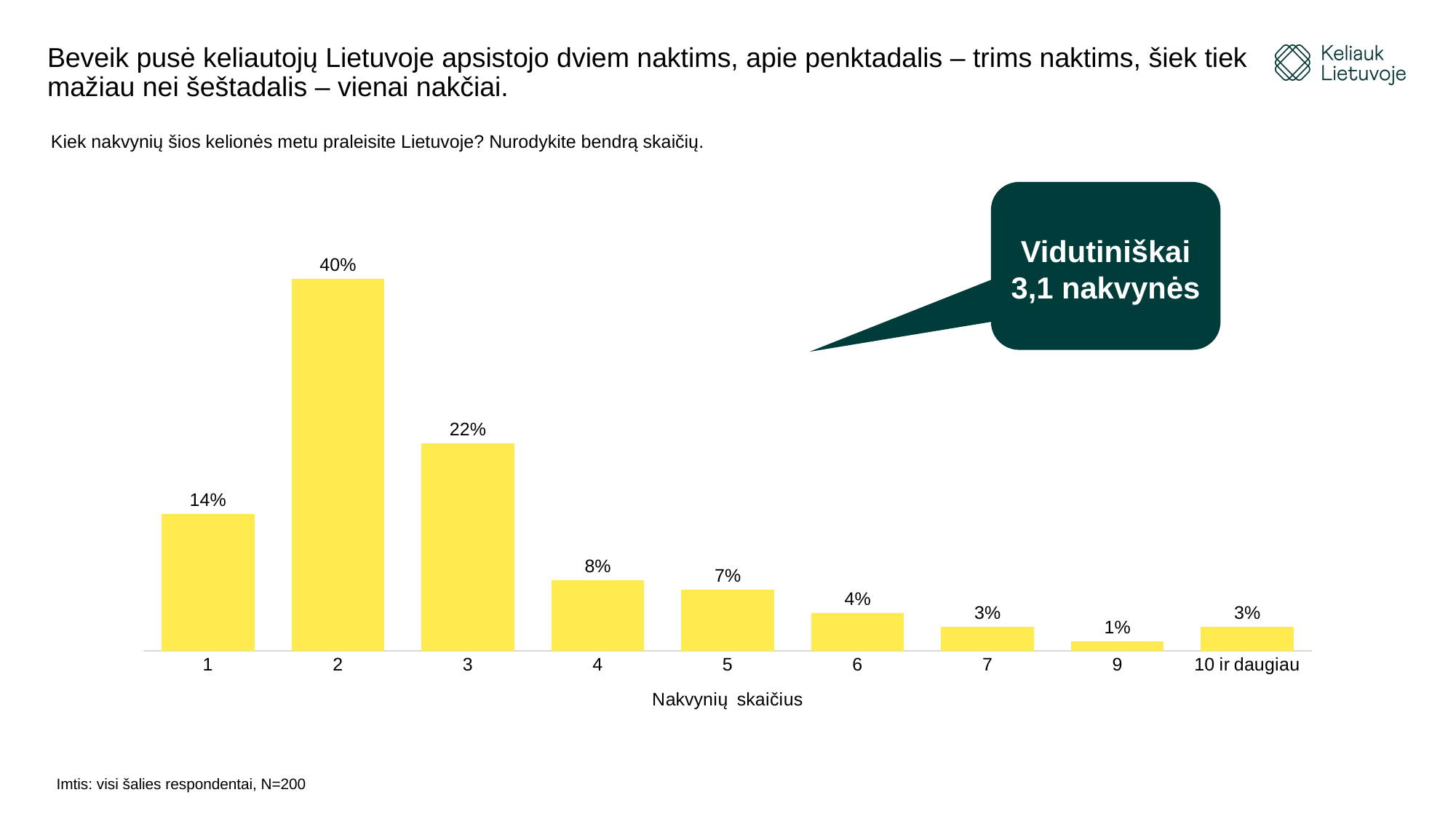
What is the x-axis title of the chart? Nakvynių skaičius What kind of chart is shown on the slide? Bar chart What percentage of travellers stay 1 night? 14% Which is larger, the value for 4 nights or the value for 5 nights? 4 nights How many categories are shown on the x axis? 9 What percentage of travellers stay 2 nights? 40% What is the difference between the values for 2 nights and 3 nights? 18% Which category has the lowest value? 9 Do the values rise or fall from 2 nights to 9 nights along the x axis? Fall Which number of nights has the highest share of travellers? 2 What average number of nights is stated in the callout box? 3,1 nakvynės What is the value for the category '10 ir daugiau'? 3%